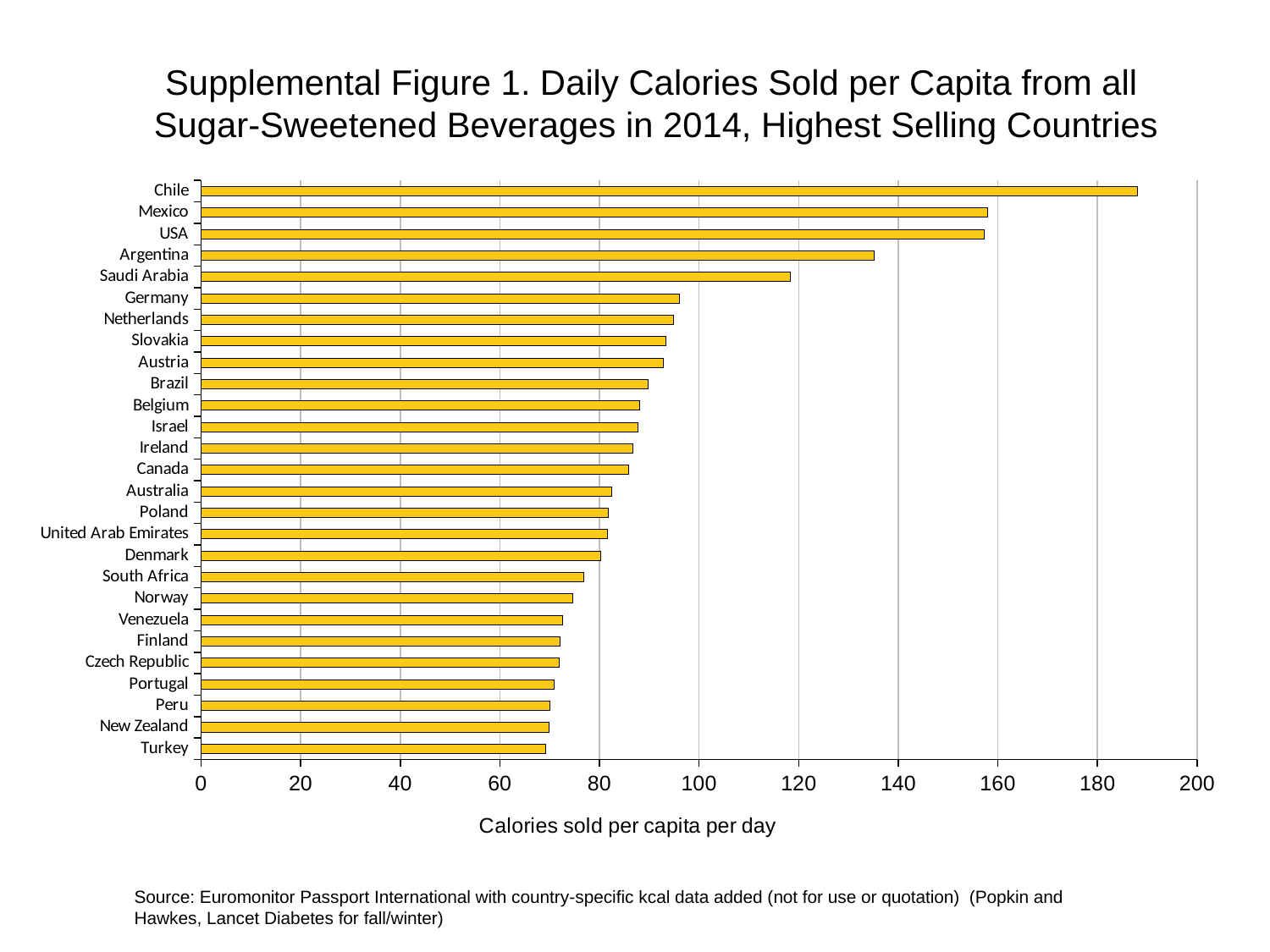
Which has a larger value, Argentina or Saudi Arabia? Argentina Is the value for Chile greater or less than 180? greater What is the label of the horizontal axis? Calories sold per capita per day How many countries are shown in the chart? 27 Which country has the highest daily calories sold per capita? Chile Is the value for Germany greater or less than 100? less Is the value for Brazil greater or less than 80? greater Which country has the lowest daily calories sold per capita? Turkey What kind of chart is shown on the slide? bar chart Which has a larger value, Germany or Brazil? Germany